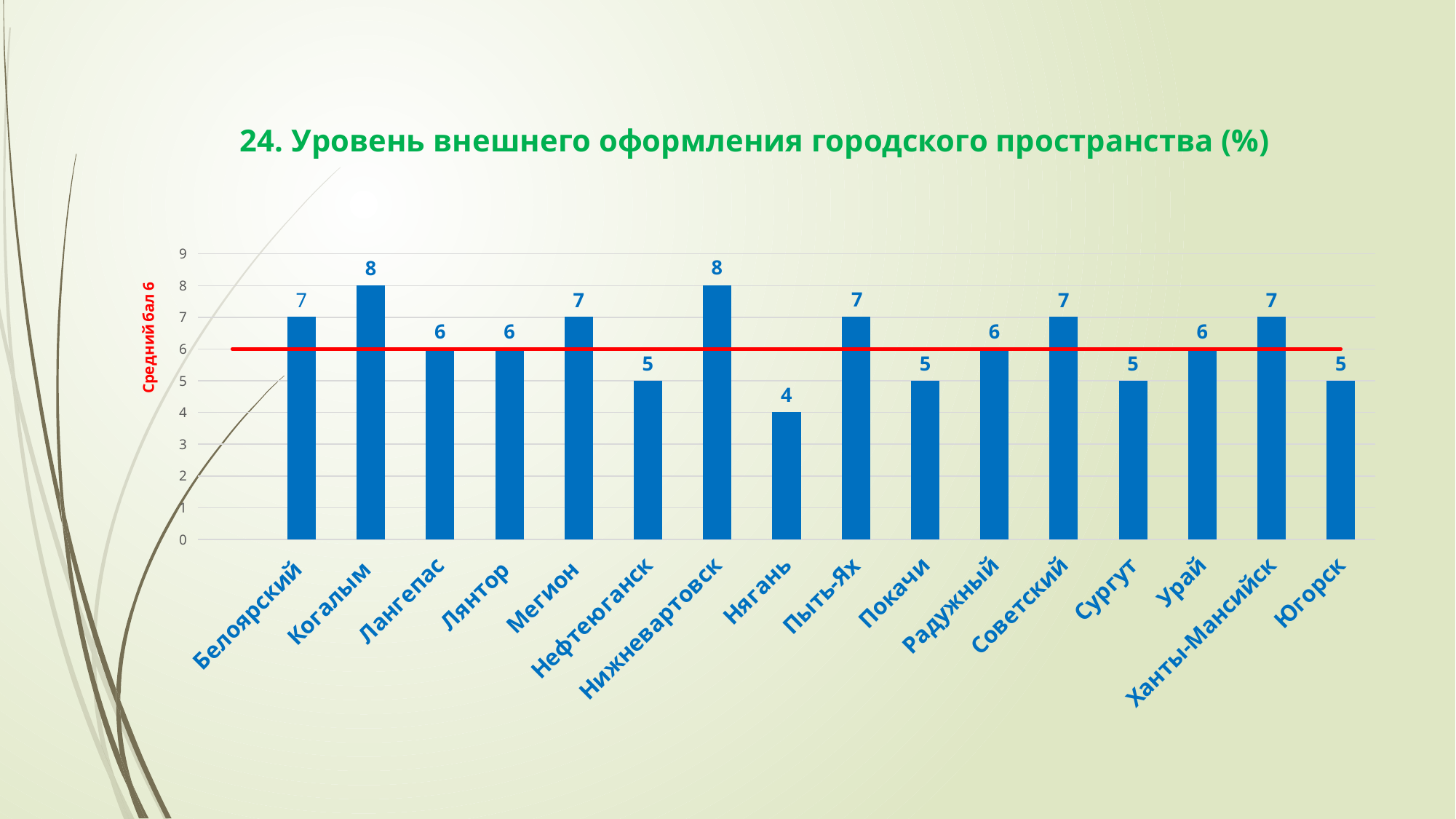
What kind of chart is this? Bar chart What value does the red horizontal line mark, according to its label? 6 What is the value for Сургут? 5 Which city has the lowest value? Нягань Which cities share the highest value on the chart? Когалым and Нижневартовск What is the difference between the values for Нижневартовск and Нягань? 4 Which is larger, the value for Мегион or the value for Нефтеюганск? Мегион What is the value for Нягань? 4 What is the title of the chart? 24. Уровень внешнего оформления городского пространства (%) What is the value for Когалым? 8 How many cities are shown on the chart? 16 What is the value for Ханты-Мансийск? 7